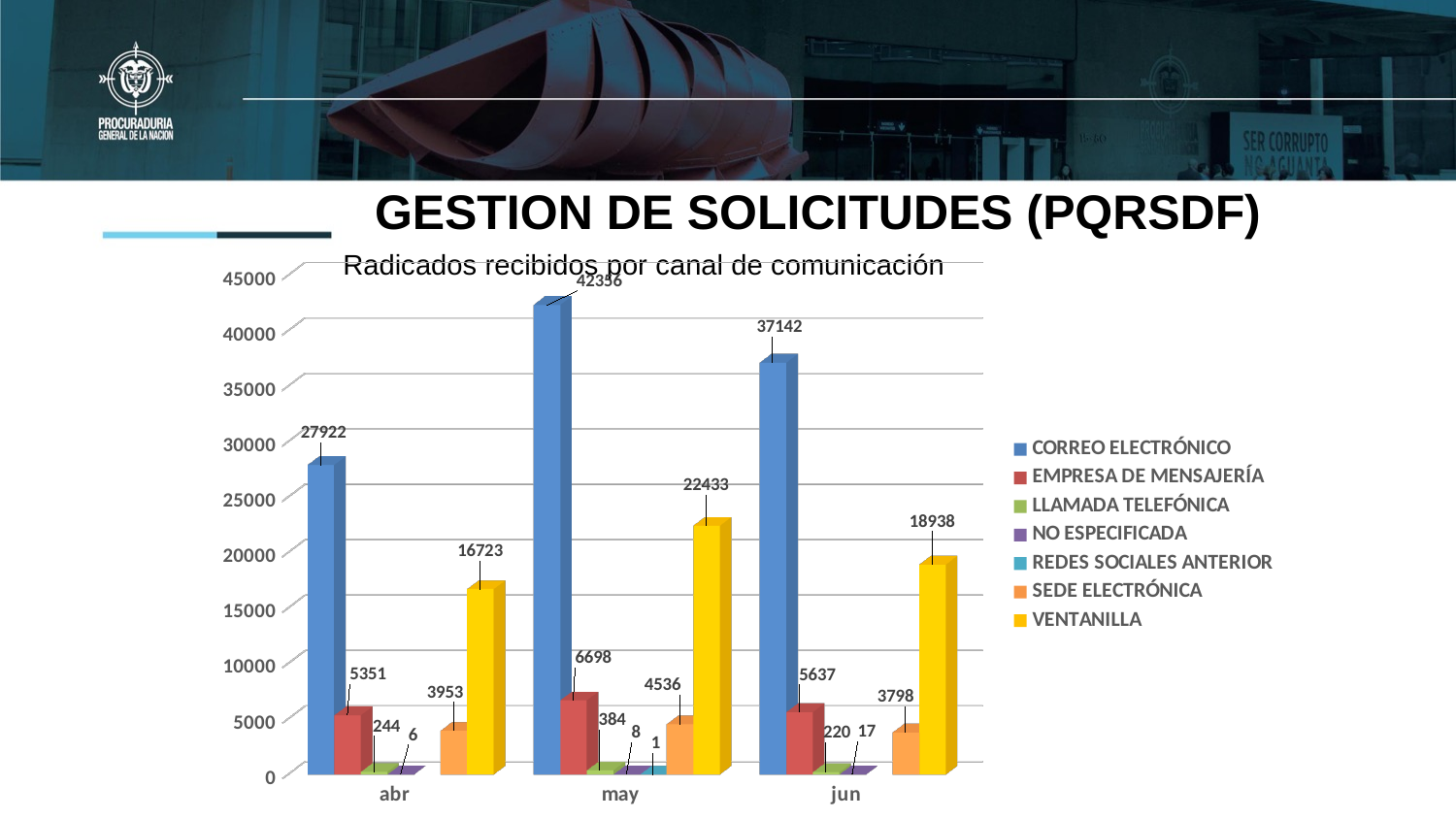
What is the value for EMPRESA DE MENSAJERÍA in abr? 5351 What kind of chart is shown? bar chart What is the value for CORREO ELECTRÓNICO in may? 42356 What is the title of the chart? Radicados recibidos por canal de comunicación In which month is the CORREO ELECTRÓNICO value highest? may What is the value for VENTANILLA in jun? 18938 How many series does the legend list? 7 Which is larger, the EMPRESA DE MENSAJERÍA value in may or in jun? may In which month is the VENTANILLA value lowest? abr What is the difference between the CORREO ELECTRÓNICO values for may and jun? 5214 How many months are shown on the x axis? 3 What is the value for SEDE ELECTRÓNICA in may? 4536